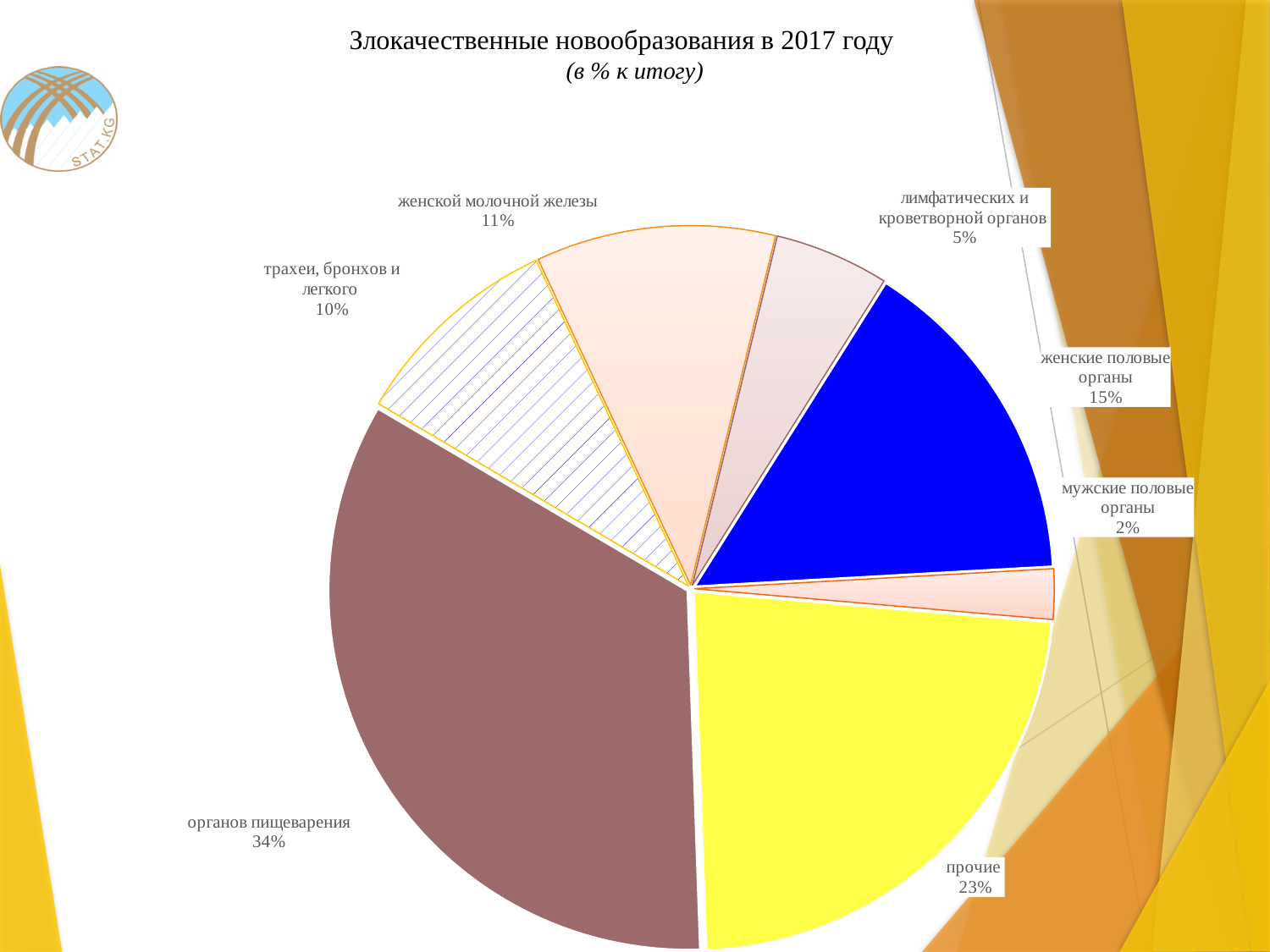
What kind of chart is shown on the slide? pie chart What is the share for трахеи, бронхов и легкого? 10% Which category has the smallest slice of the pie? мужские половые органы What is the difference between the shares of органов пищеварения and прочие? 11% What is the share for органов пищеварения? 34% Which is larger, the share for женской молочной железы or the share for лимфатических и кроветворной органов? женской молочной железы Which category has the largest slice of the pie? органов пищеварения What is the share for мужские половые органы? 2% What is the share for прочие? 23% How many categories are shown in the pie chart? 7 What is the share for женские половые органы? 15% What is the title of the chart? Злокачественные новообразования в 2017 году (в % к итогу)